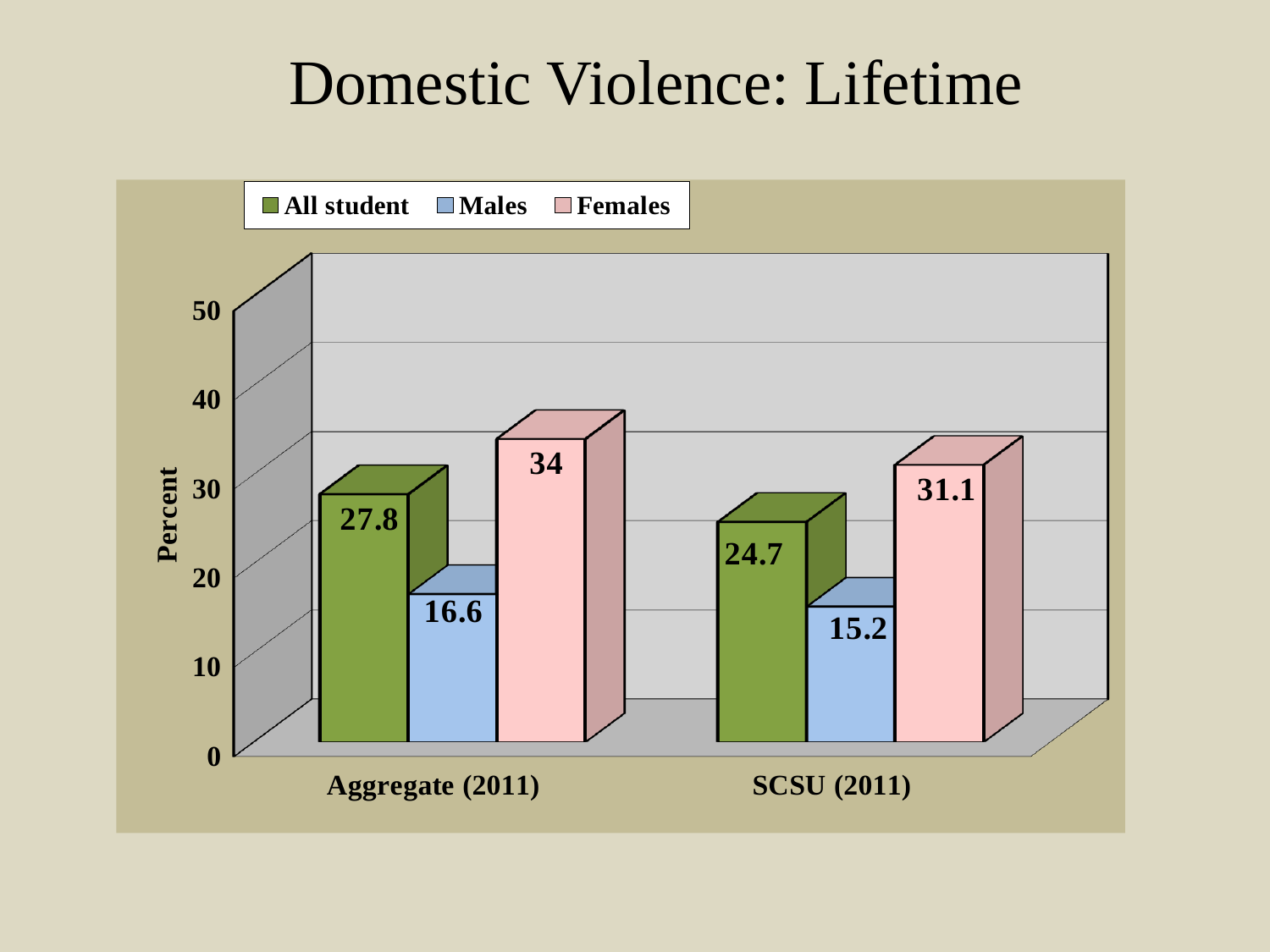
What is the value for Females in the Aggregate (2011) group? 34 Is the value for Females in the Aggregate (2011) group greater or less than 30? greater Which series has the lowest value in the Aggregate (2011) group? Males What is the label of the vertical axis? Percent What is the value for All student in the Aggregate (2011) group? 27.8 Which series has the highest value in the SCSU (2011) group? Females How many categories are shown on the x axis? 2 What is the value for Males in the SCSU (2011) group? 15.2 What is the difference between the Females and Males values in the SCSU (2011) group? 15.9 How many series does the legend list? 3 Which is larger, the All student value for Aggregate (2011) or for SCSU (2011)? Aggregate (2011) What kind of chart is shown on the slide? Bar chart